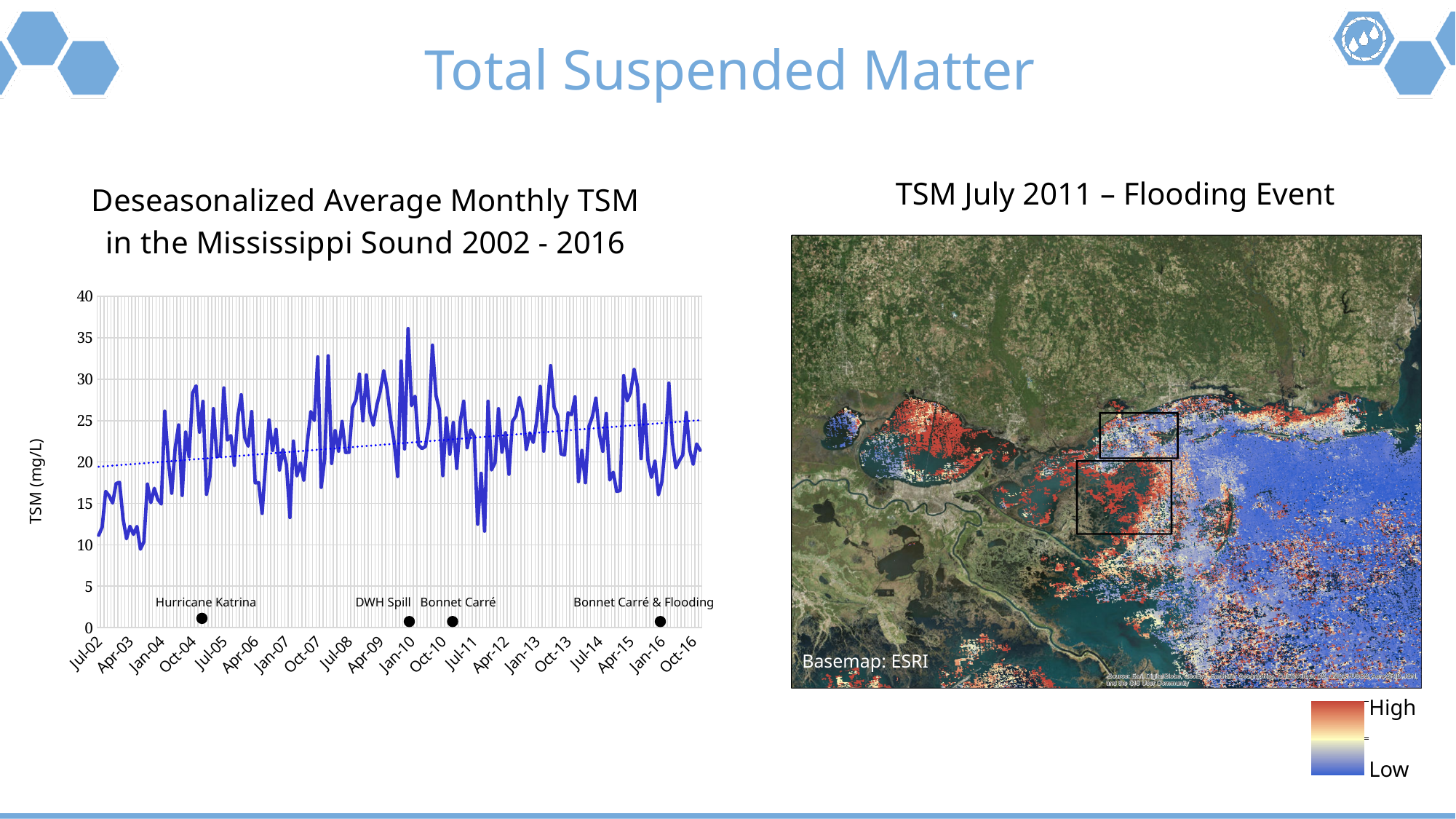
What is the maximum value shown on the y-axis of the Deseasonalized Average Monthly TSM chart? 40 In the Deseasonalized Average Monthly TSM chart, is the highest peak of the line (around Jan-10) greater or less than 30? greater In the Deseasonalized Average Monthly TSM chart, is the lowest point of the line (around early 2003) greater or less than 15? less In the Deseasonalized Average Monthly TSM chart, does the dotted trend line rise or fall from Jul-02 to Oct-16? Rises In the Deseasonalized Average Monthly TSM chart, which marked event occurs latest in time? Bonnet Carré & Flooding What is the first x-axis label on the Deseasonalized Average Monthly TSM chart? Jul-02 How many events are marked with black dots along the bottom of the Deseasonalized Average Monthly TSM chart? 4 What is the label of the y-axis in the Deseasonalized Average Monthly TSM chart? TSM (mg/L) In the Deseasonalized Average Monthly TSM chart, which marked event occurs earliest in time? Hurricane Katrina In the Deseasonalized Average Monthly TSM chart, is the TSM value at the end of the series (Oct-16) greater or less than 15? greater What kind of chart is the "Deseasonalized Average Monthly TSM in the Mississippi Sound 2002 - 2016" chart? Line chart